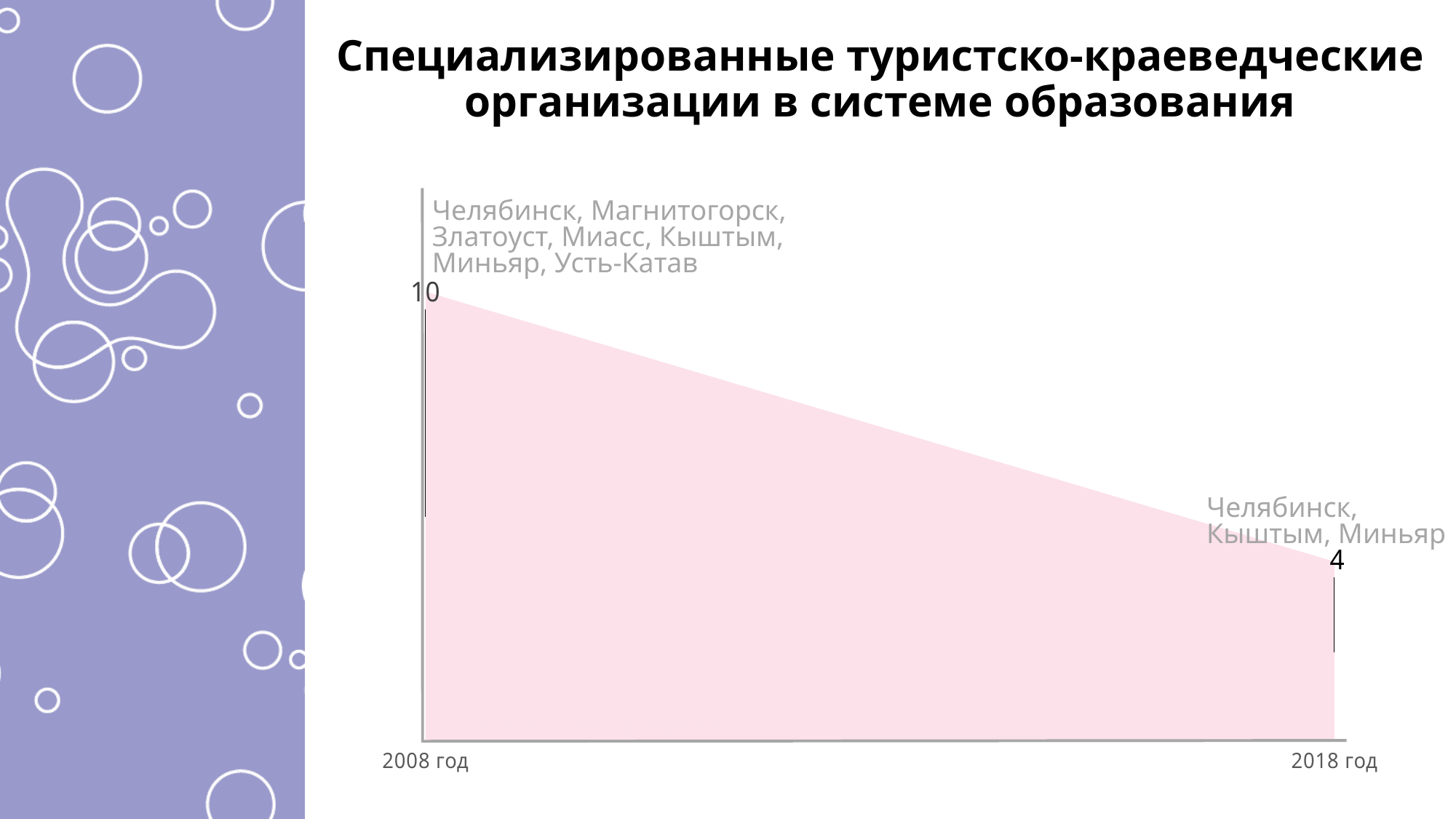
Which year has the lowest value? 2018 год Do the values rise or fall from 2008 год to 2018 год? fall Which cities are listed next to the 2018 год data point? Челябинск, Кыштым, Миньяр What is the title of the slide? Специализированные туристско-краеведческие организации в системе образования What is the difference between the values for 2008 год and 2018 год? 6 Which year has the highest value? 2008 год How many data points are plotted on the chart? 2 Which is larger, the value for 2008 год or the value for 2018 год? 2008 год What is the value for 2018 год? 4 What kind of chart is shown on the slide? area chart What is the value for 2008 год? 10